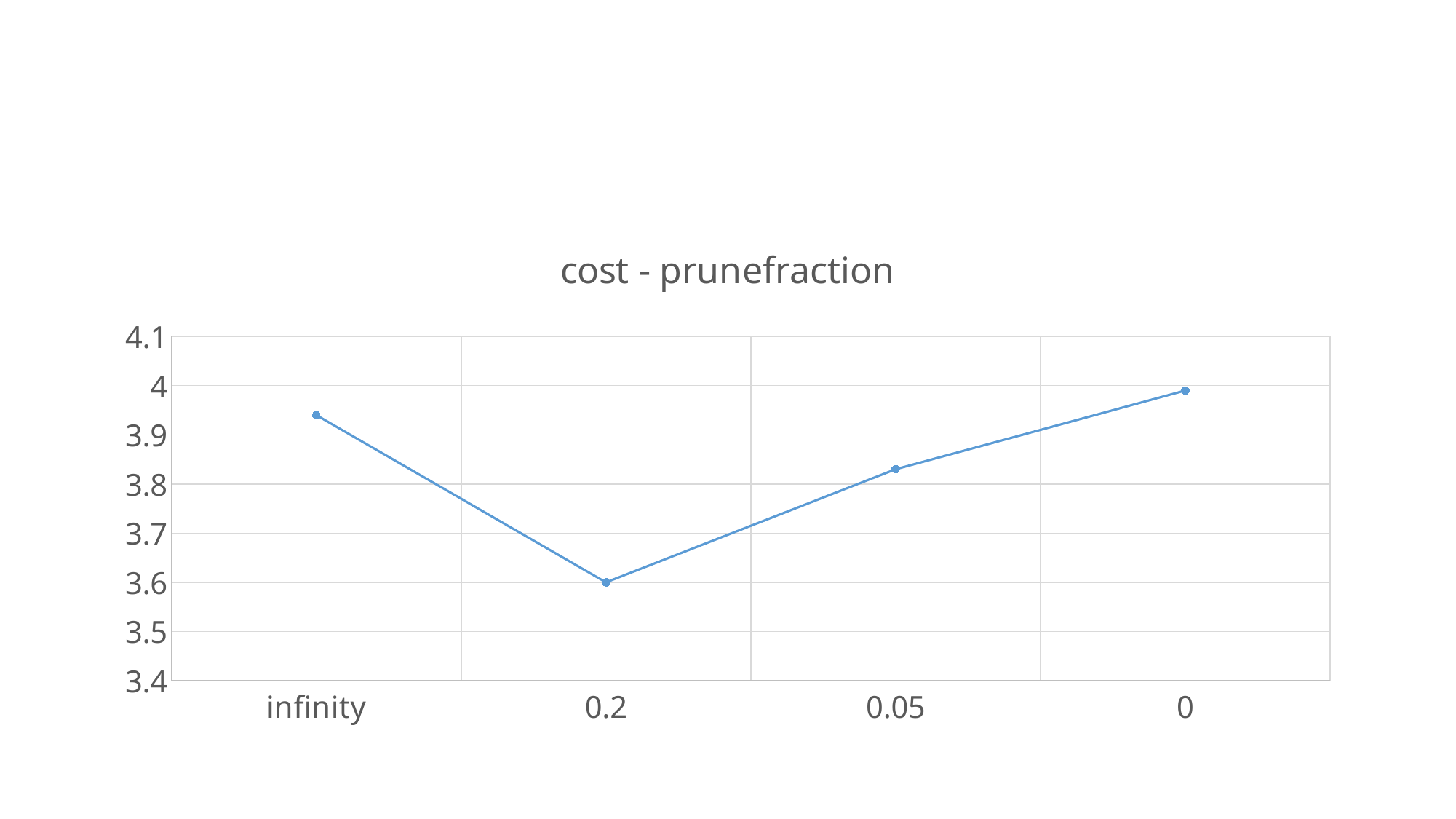
Which is larger, the value for 0.05 or the value for 0? 0 How many data points are plotted on the chart? 4 What type of chart is shown on the slide? line chart What is the value at prunefraction 0.2? 3.6 Is the value for 0.05 greater or less than 3.8? greater What is the title of the chart? cost - prunefraction Which is larger, the value for infinity or the value for 0.2? infinity Which category has the highest value? 0 How do the values change from 0.2 to 0 along the x axis? they rise Is the value for infinity greater or less than 3.9? greater Which category has the lowest value? 0.2